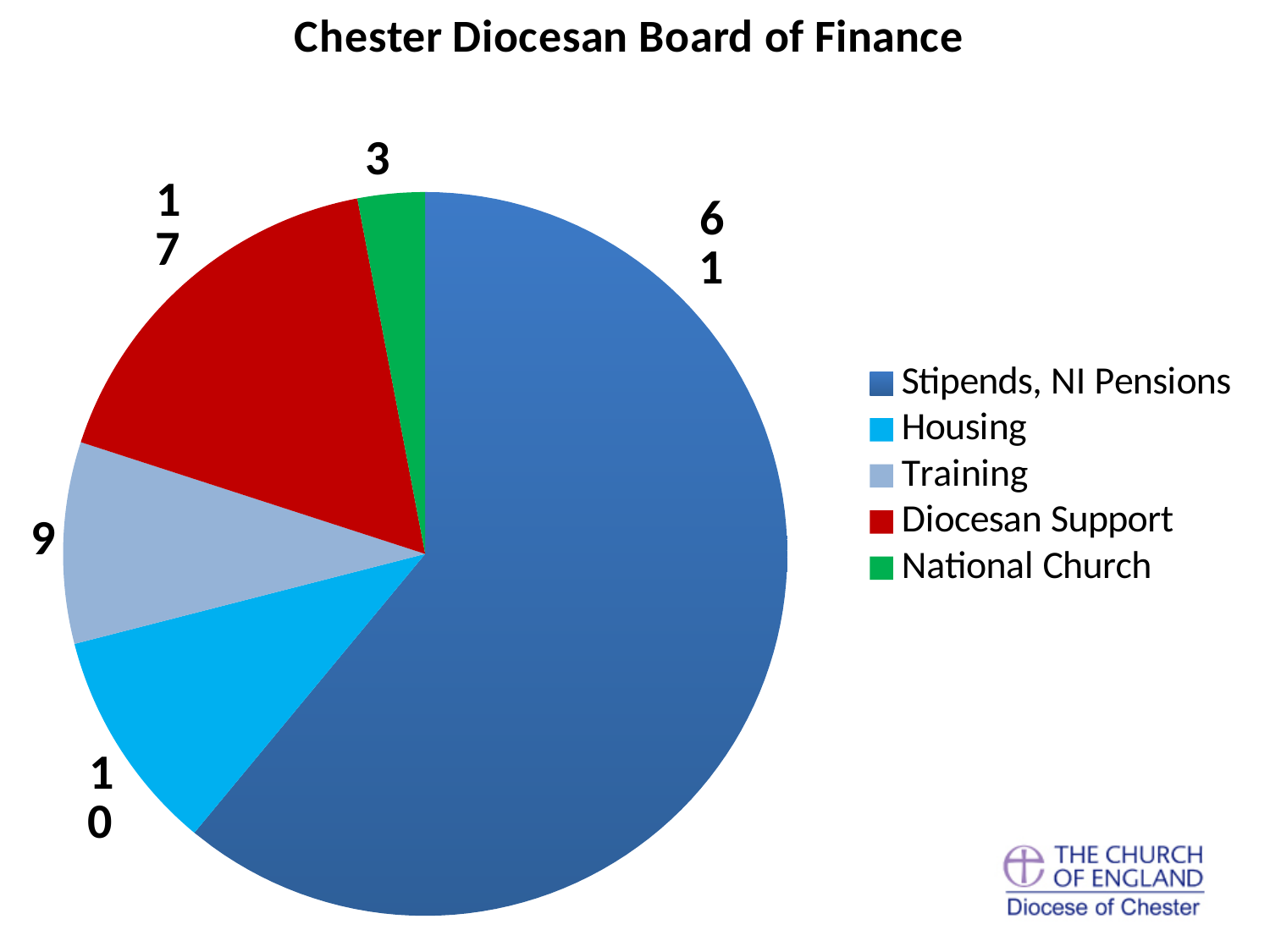
Which category is shown in green in the legend? National Church What is the title of the chart? Chester Diocesan Board of Finance Which is larger, the value for Housing or the value for Training? Housing What is the difference between the values for Diocesan Support and Training? 8 Which category has the largest slice of the pie? Stipends, NI Pensions What type of chart is shown on the slide? pie chart How many slices does the pie chart have? 5 What is the value shown for Diocesan Support? 17 What is the value shown for Housing? 10 Which category has the smallest slice of the pie? National Church What is the value shown for National Church? 3 What is the value shown for Stipends, NI Pensions? 61